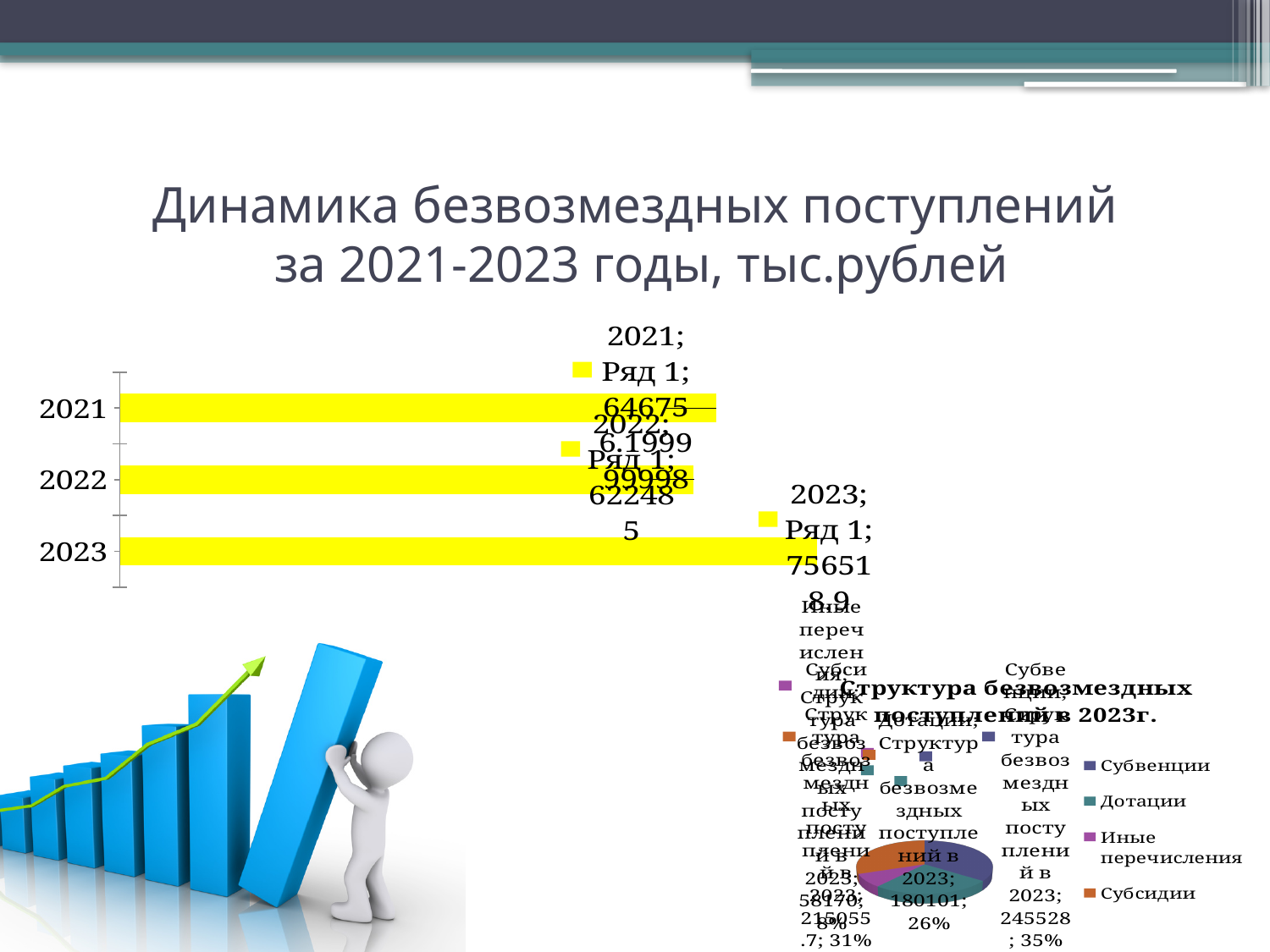
In the pie chart on the right, what share of the total is Дотации? 26% In the bar chart on the left, how many years (categories) are shown? 3 In the bar chart on the left, what is the value for 2022? 622485 In the bar chart on the left, which year has the highest value? 2023 In the bar chart on the left, which is larger, the value for 2023 or the value for 2022? 2023 In the pie chart on the right, how many entries does the legend list? 4 In the pie chart on the right, which category has the largest slice? Субвенции What kind of chart is the chart on the right of the slide, titled 'Структура безвозмездных поступлений в 2023г.'? pie chart In the pie chart on the right, what is the value for Дотации? 180101 In the pie chart on the right, what share of the total is Субвенции? 35% What kind of chart is the chart on the left of the slide, titled 'Динамика безвозмездных поступлений за 2021-2023 годы, тыс.рублей'? bar chart In the bar chart on the left, what is the value for 2023? 756518.9